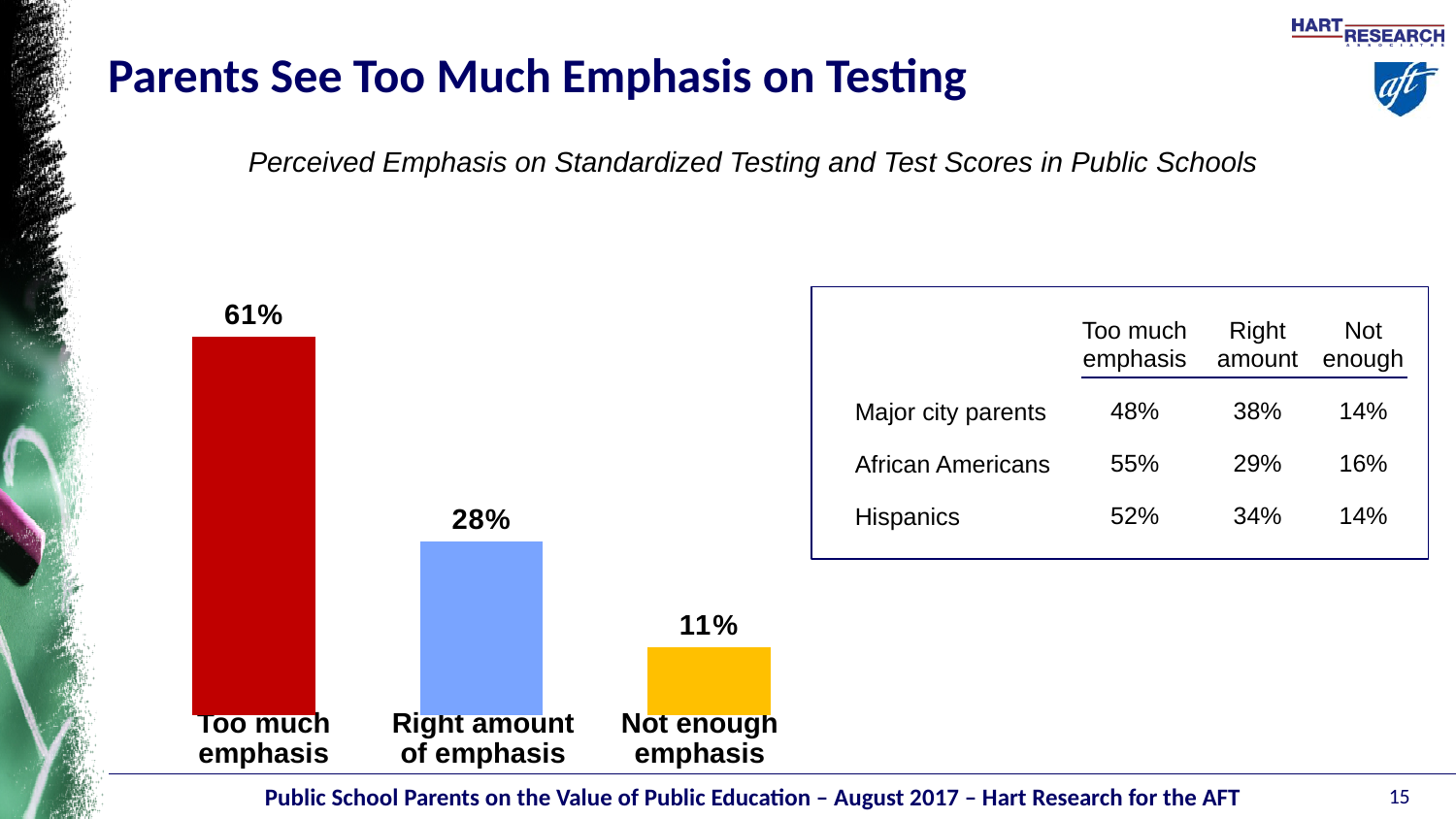
What percentage of parents say there is too much emphasis on standardized testing? 61% What type of chart is shown on the slide? Bar chart What colour is the 'Too much emphasis' bar? Red Which category has the lowest value in the bar chart? Not enough emphasis Which category has the highest value in the bar chart? Too much emphasis What is the difference between the 'Right amount of emphasis' and 'Not enough emphasis' values? 17 percentage points What is the value for the 'Right amount of emphasis' bar? 28% What is the difference between the 'Too much emphasis' and 'Right amount of emphasis' values? 33 percentage points How many categories are shown in the bar chart? 3 Which is larger, the value for 'Right amount of emphasis' or 'Not enough emphasis'? Right amount of emphasis What is the value for the 'Not enough emphasis' bar? 11% Do the values rise or fall moving from left to right across the bars? Fall